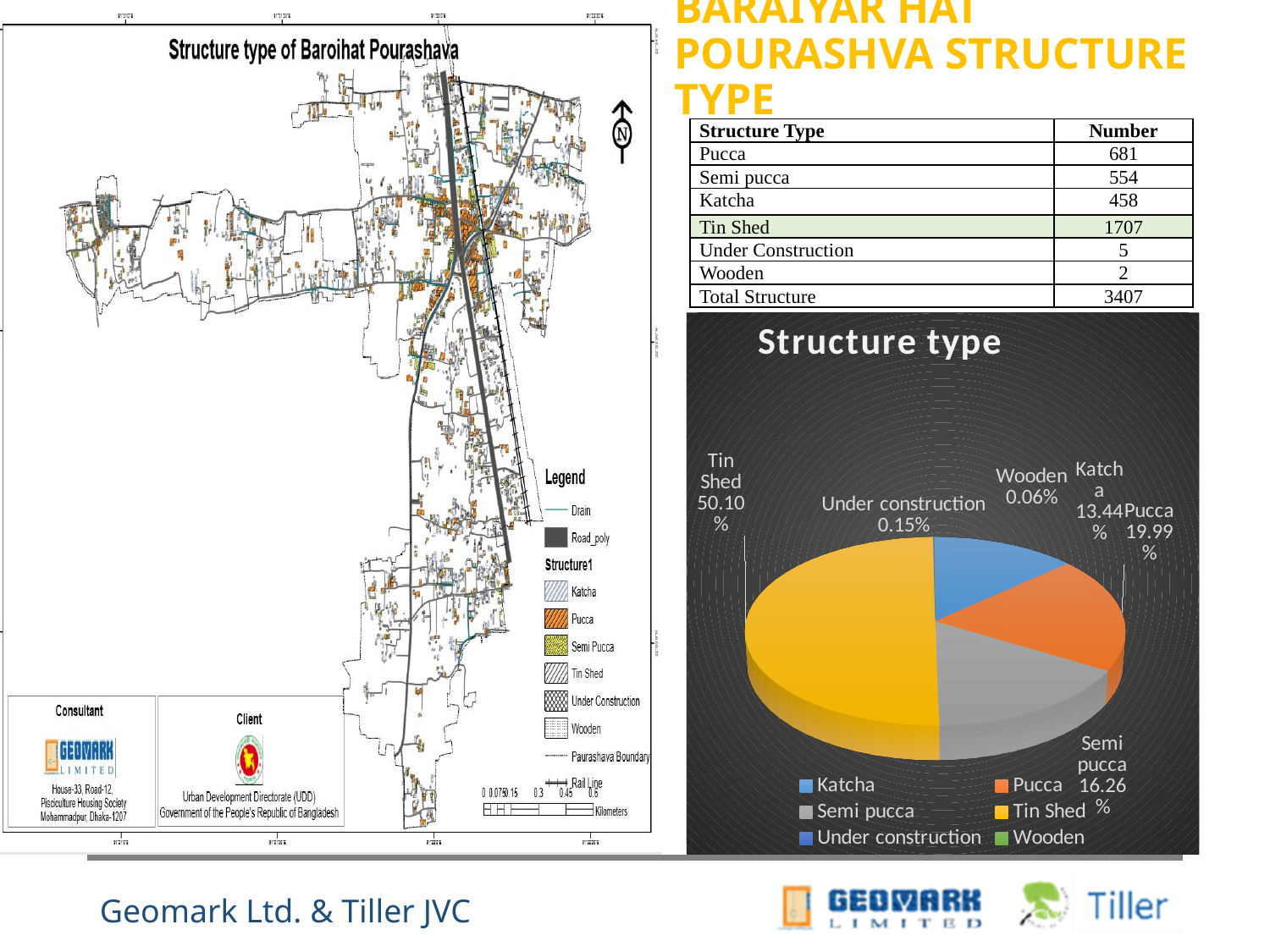
In the "Structure type" pie chart, which category has the smallest slice? Wooden In the "Structure type" pie chart, what share is labelled for Semi pucca? 16.26% In the "Structure type" pie chart, which is larger, the Pucca slice or the Katcha slice? Pucca What is the title of the pie chart on the slide? Structure type What type of chart is the "Structure type" chart? pie chart In the "Structure type" pie chart, what share is labelled for Under construction? 0.15% In the "Structure type" pie chart, what share is labelled for Pucca? 19.99% How many categories does the legend of the "Structure type" pie chart list? 6 In the "Structure type" pie chart, which category has the largest slice? Tin Shed In the "Structure type" pie chart, what share is labelled for Wooden? 0.06% In the "Structure type" pie chart, what share is labelled for Tin Shed? 50.10% In the "Structure type" pie chart, what share is labelled for Katcha? 13.44%